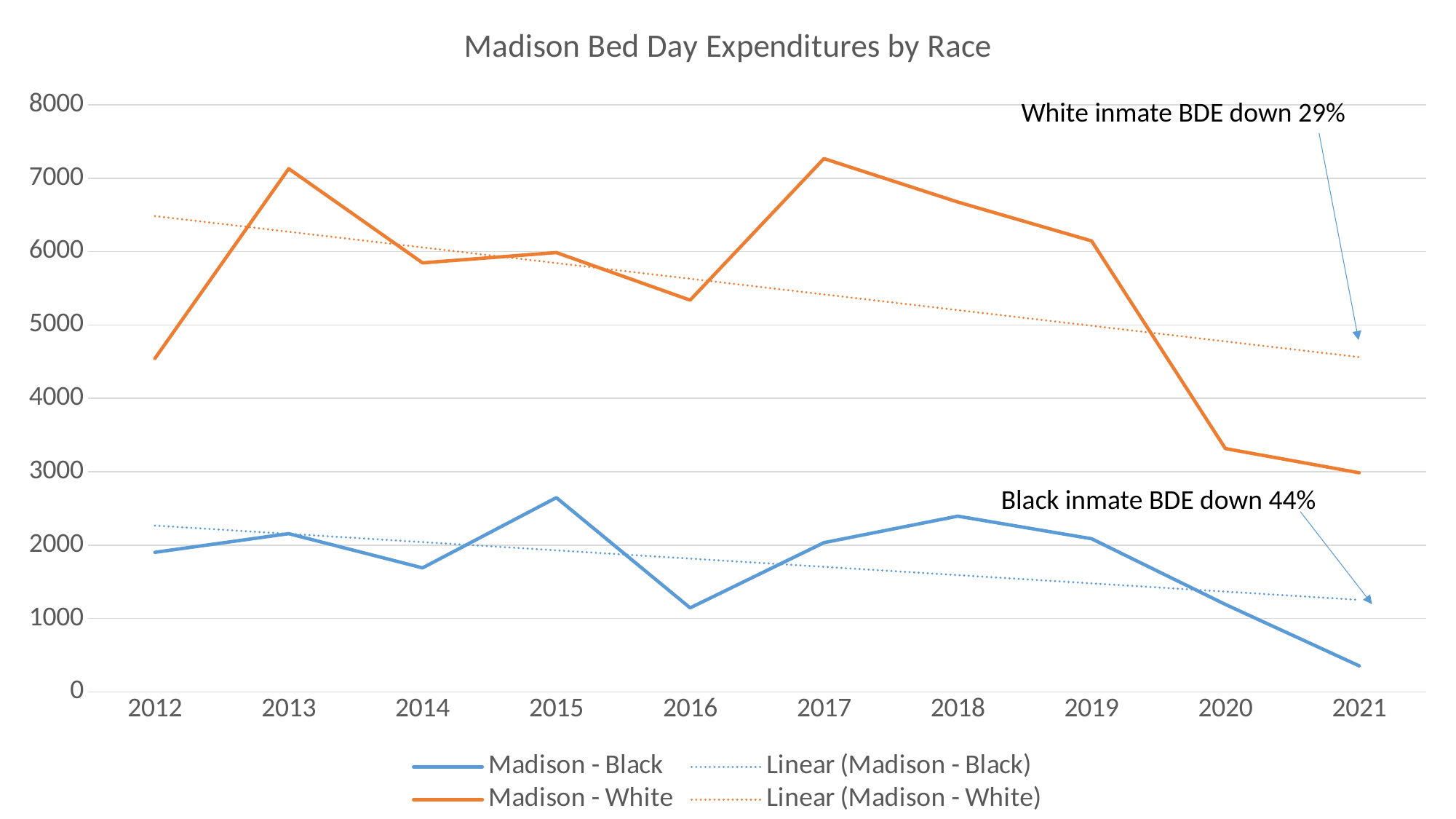
Is the value for Madison - White in 2013 greater or less than 7000? greater Is the value for Madison - Black in 2021 greater or less than 1000? less How many years are shown on the x axis? 10 In which year is the Madison - White series at its lowest? 2021 Is the value for Madison - White in 2012 greater or less than 5000? less What kind of chart is shown on the slide? line chart What is the title of the chart? Madison Bed Day Expenditures by Race In which year is the Madison - Black series at its lowest? 2021 According to the annotation on the chart, by what percentage is Black inmate BDE down? 44% In which year is the Madison - Black series at its highest? 2015 How many series does the legend list? 4 Which series has the higher value in 2019, Madison - Black or Madison - White? Madison - White